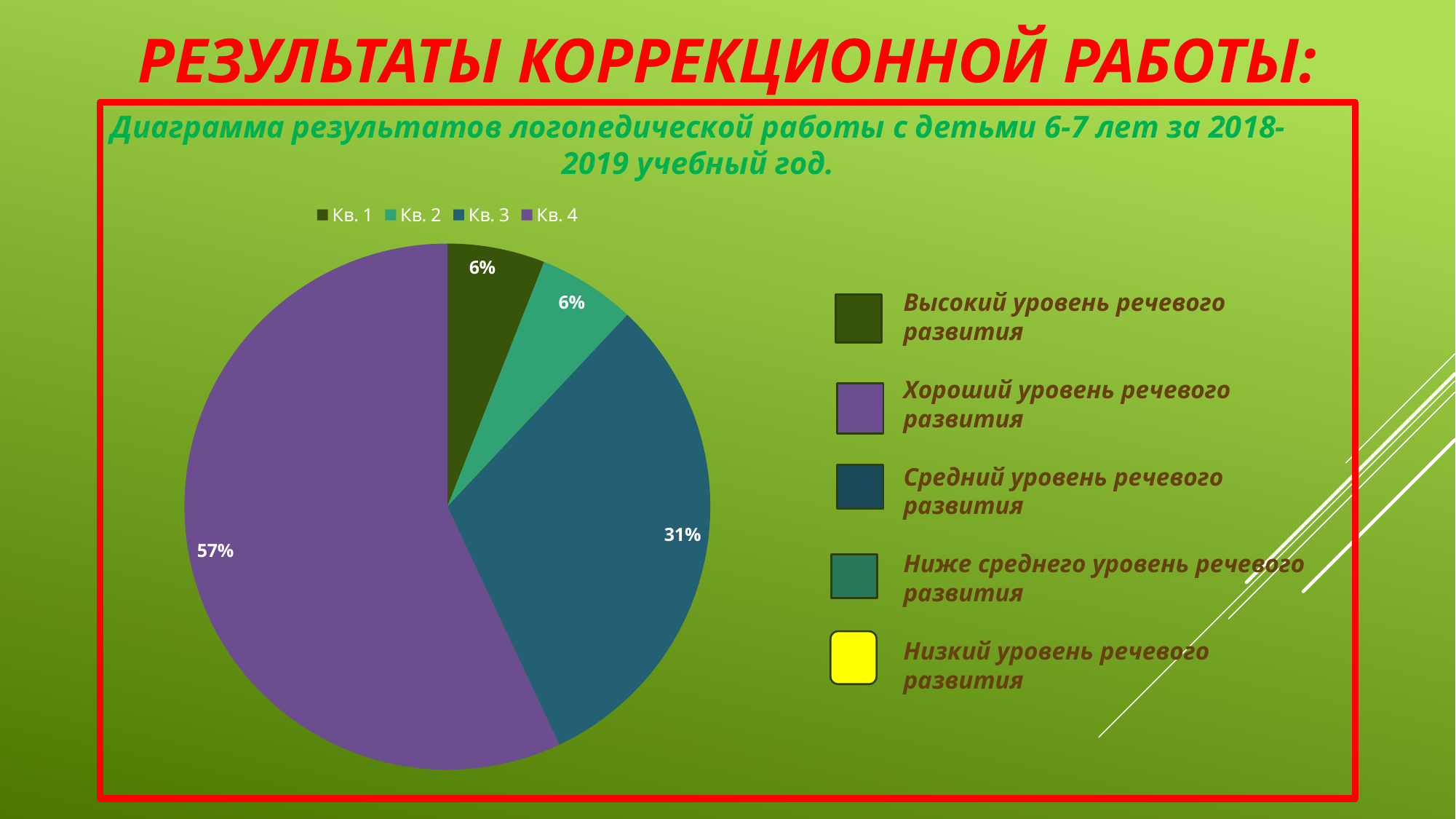
What percentage does the Кв. 3 slice represent? 31% How many entries does the chart legend list? 4 By how many percentage points does the Кв. 4 slice exceed the Кв. 3 slice? 26 What colour is the Кв. 4 slice of the pie chart? purple How many slices does the pie chart have? 4 What percentage does the Кв. 4 slice represent? 57% According to the key on the right, which level of speech development does the purple colour represent? Хороший уровень речевого развития What percentage does the Кв. 1 slice represent? 6% Which is larger, the Кв. 3 slice or the Кв. 4 slice? Кв. 4 What kind of chart is shown on the slide? pie chart Which slice of the pie chart is the largest? Кв. 4 What percentage does the Кв. 2 slice represent? 6%